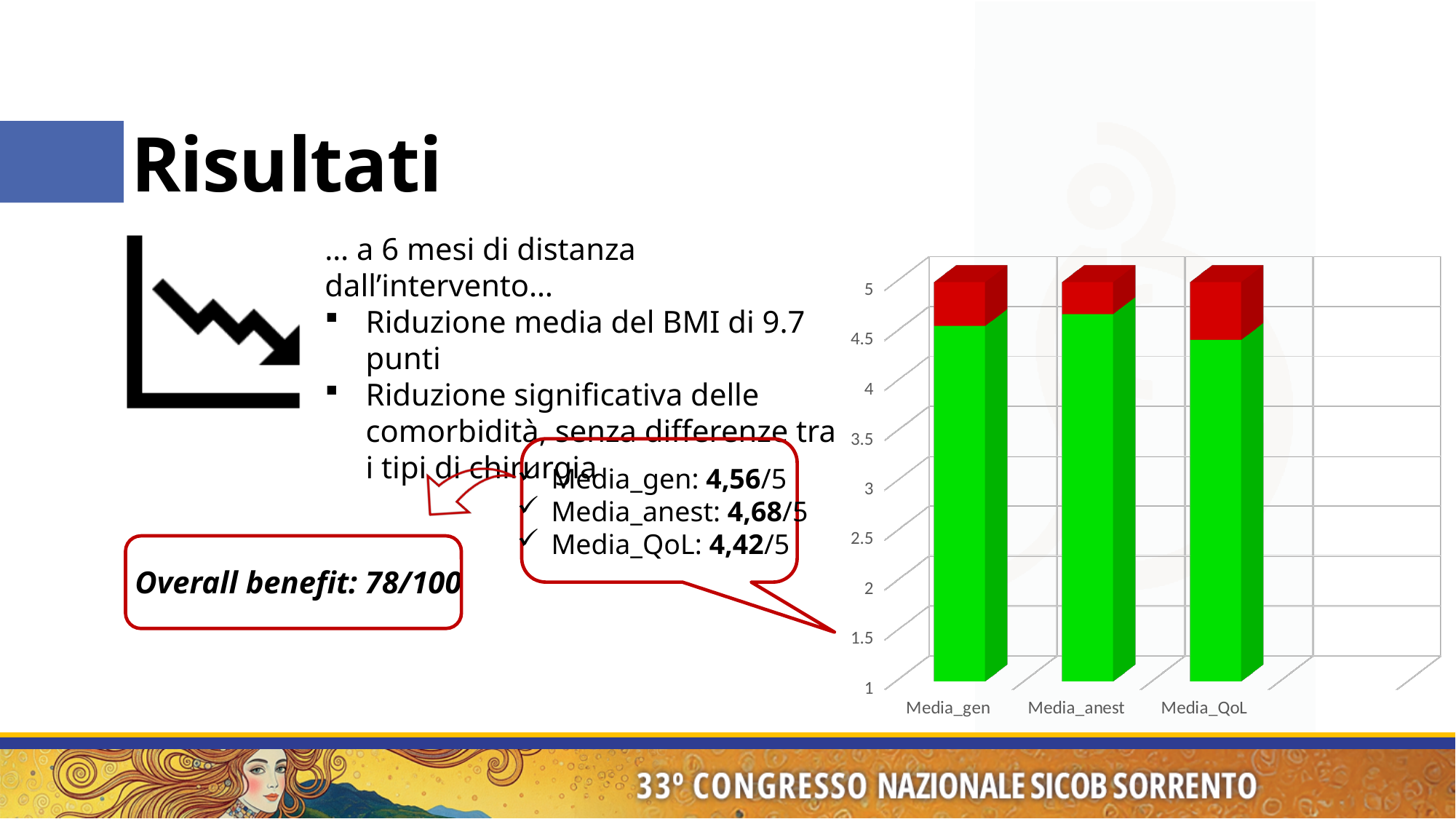
What two colours are used for the segments of the stacked bars? green and red Which is larger, the green bar for Media_gen or for Media_QoL? Media_gen Using the values in the callout, what is the difference between Media_anest and Media_QoL? 0,26 Which category has the lowest green bar in the chart? Media_QoL Is the green bar for Media_QoL greater or less than 4.5? less According to the callout on the slide, what is the value for Media_QoL? 4,42/5 According to the callout on the slide, what is the value for Media_gen? 4,56/5 According to the callout on the slide, what is the value for Media_anest? 4,68/5 Which category has the highest green bar in the chart? Media_anest How many categories are plotted on the x axis of the chart? 3 What kind of chart is shown on the slide? bar chart Is the green bar for Media_anest greater or less than 4.5? greater